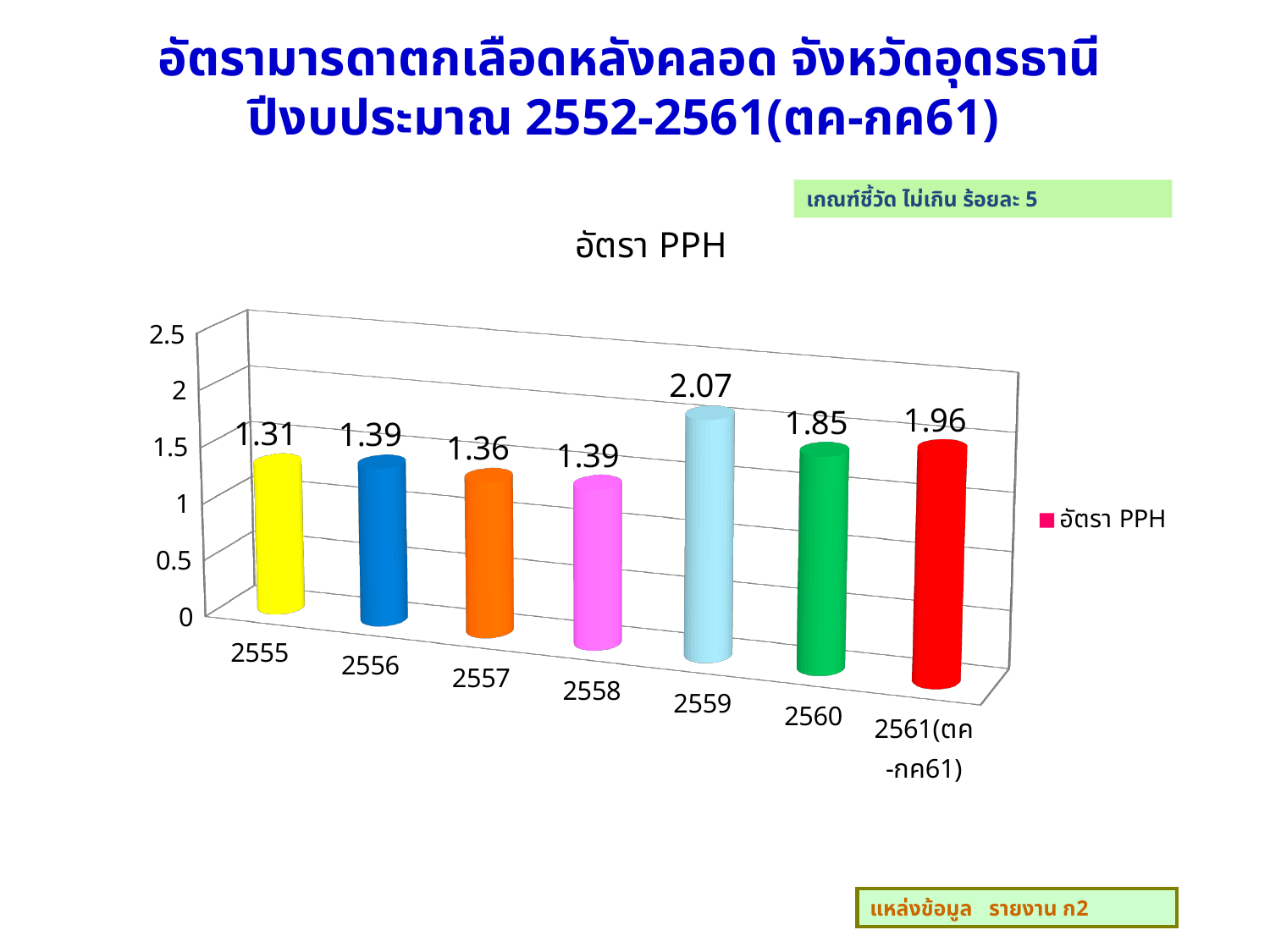
What is the value for 2559? 2.07 Which year has the highest value? 2559 What is the value for 2555? 1.31 Which year has the lowest value? 2555 How many series does the legend list? 1 What is the title of the chart? อัตรา PPH Which is larger, the value for 2560 or the value for 2561(ตค-กค61)? 2561(ตค-กค61) What kind of chart is shown? bar chart Is the value for 2559 greater or less than 2? greater What is the difference between the values for 2559 and 2560? 0.22 What is the value for 2561(ตค-กค61)? 1.96 How many years are shown on the x axis? 7